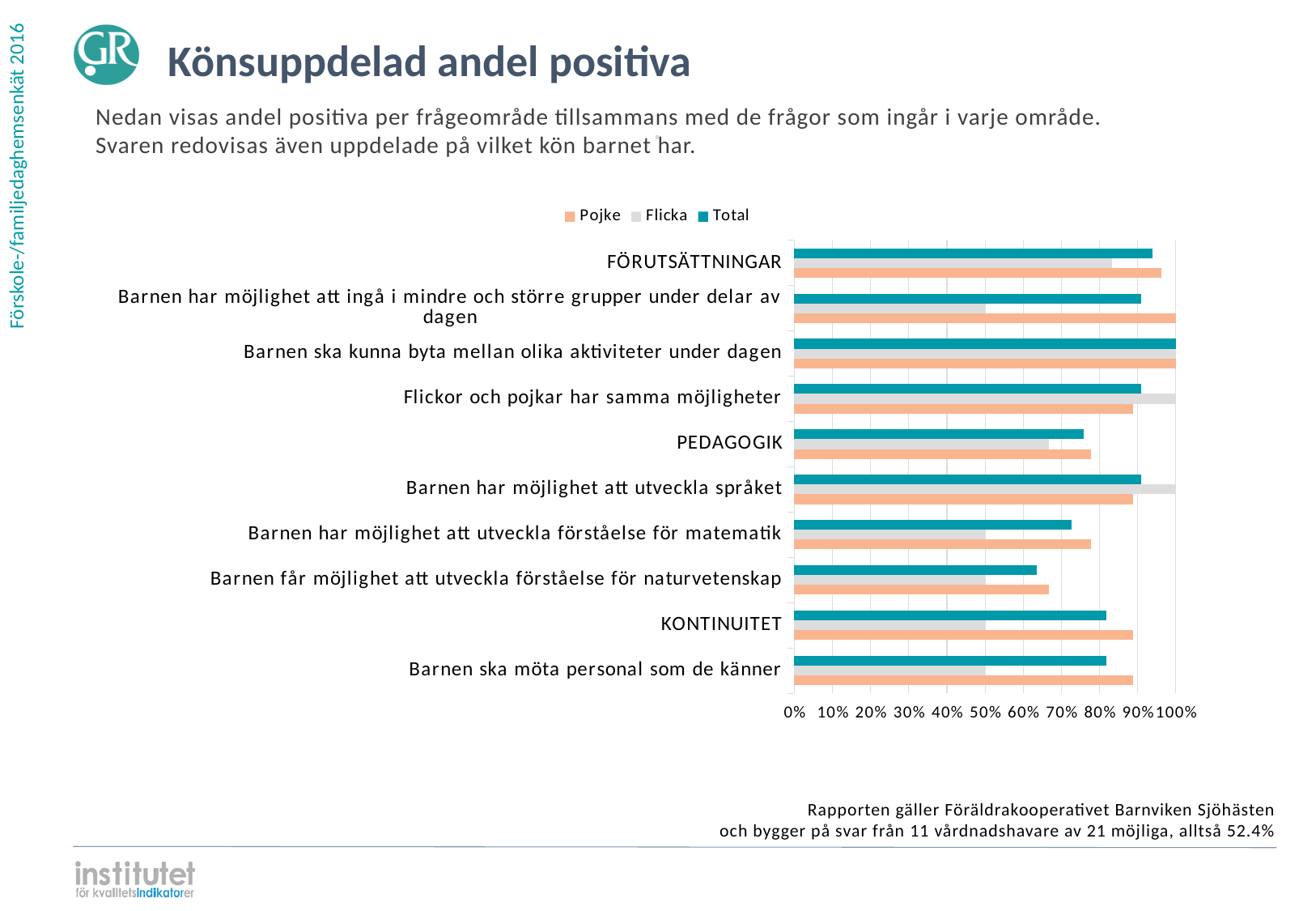
Which category has the lowest Total value? Barnen får möjlighet att utveckla förståelse för naturvetenskap What is the Pojke value for 'Barnen har möjlighet att ingå i mindre och större grupper under delar av dagen'? 100% Is the Total value for 'Barnen får möjlighet att utveckla förståelse för naturvetenskap' greater or less than 70%? less What are the three series named in the legend? Pojke, Flicka, Total What is the Total value for 'Barnen ska kunna byta mellan olika aktiviteter under dagen'? 100% For KONTINUITET, which is larger, the Pojke value or the Flicka value? Pojke Is the Pojke value for FÖRUTSÄTTNINGAR greater or less than 90%? greater How many series does the legend list? 3 How many categories are plotted on the y axis of the chart? 10 Is the Flicka value for PEDAGOGIK greater or less than 60%? greater What is the Flicka value for 'Flickor och pojkar har samma möjligheter'? 100% What kind of chart is shown on the slide? bar chart